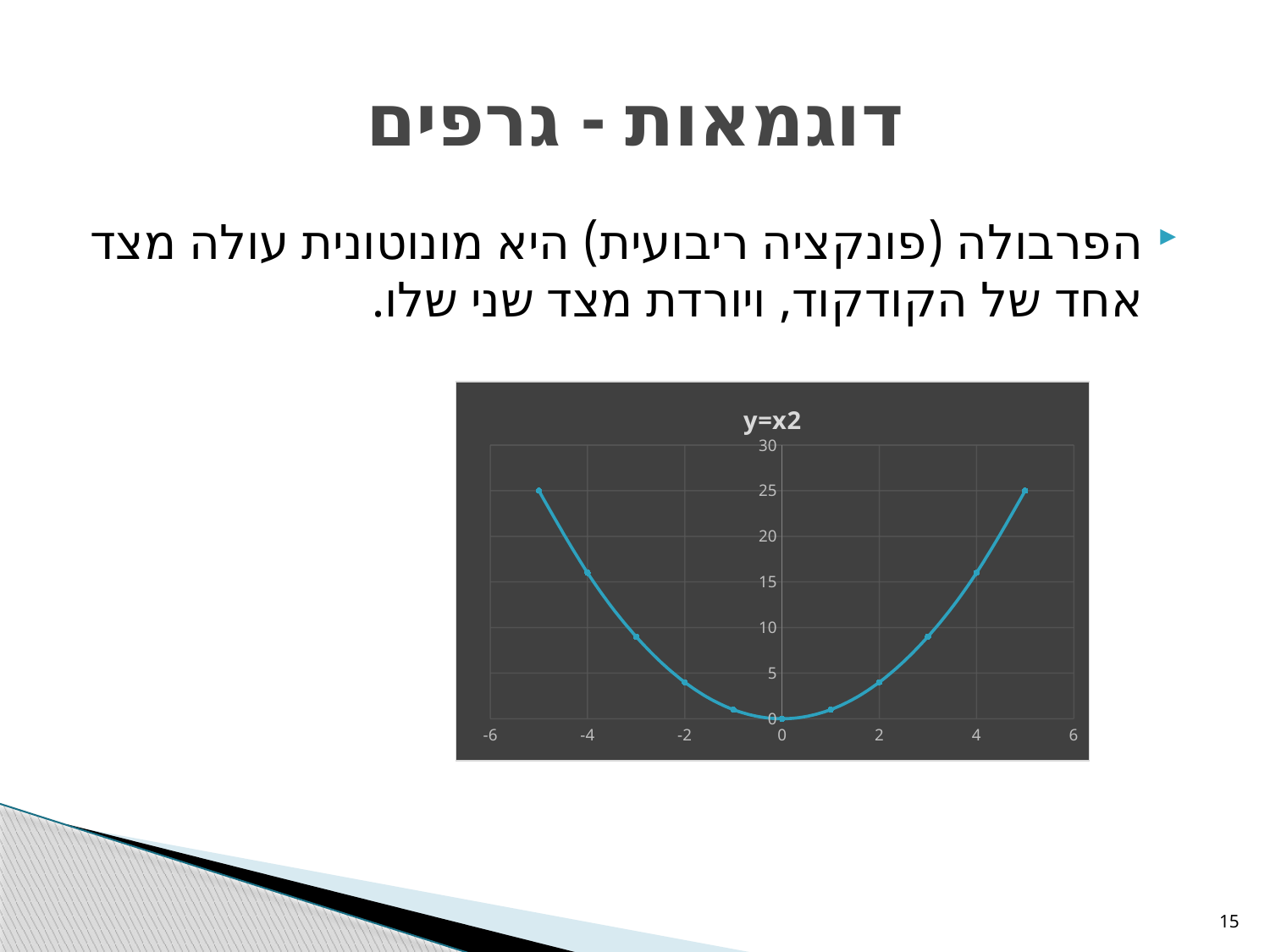
What is the y value at x = 5? 25 What is the y value at x = -5? 25 What is the title of the chart? y=x2 Do the y values rise or fall as x increases from 0 to 5? rise Which is larger, the y value at x = 3 or the y value at x = 1? x = 3 How many data points are plotted on the chart? 11 Is the y value at x = 2 greater or less than 5? less Is the y value at x = 4 greater or less than 15? greater Is the y value at x = -3 greater or less than 10? less What is the y value at x = 0? 0 At which x value is the plotted y value lowest? 0 What kind of chart is shown on the slide? line chart